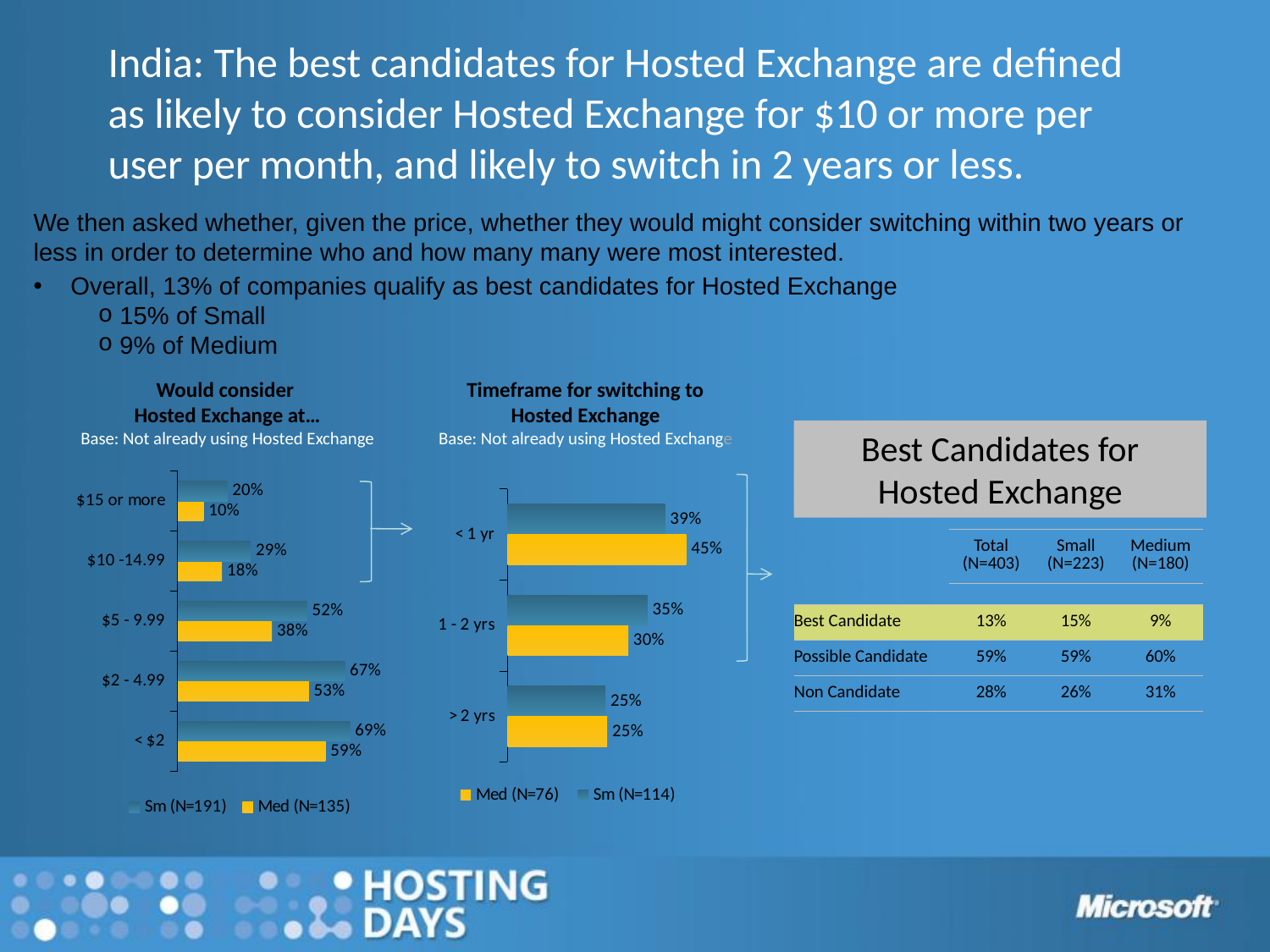
In the 'Timeframe for switching to Hosted Exchange' chart, what is the value for Sm at 1 - 2 yrs? 35% In the 'Would consider Hosted Exchange at...' chart, what is the value for Sm at $15 or more? 20% In the 'Timeframe for switching to Hosted Exchange' chart, which is larger at < 1 yr, Sm or Med? Med In the 'Would consider Hosted Exchange at...' chart, what is the value for Med at $5 - 9.99? 38% How many series does the legend of the 'Timeframe for switching to Hosted Exchange' chart list? 2 In the 'Timeframe for switching to Hosted Exchange' chart, what is the difference between Sm and Med at 1 - 2 yrs? 5% In the 'Timeframe for switching to Hosted Exchange' chart, what is the value for Med at < 1 yr? 45% In the 'Would consider Hosted Exchange at...' chart, what is the difference between the Sm and Med values at $2 - 4.99? 14% In the 'Would consider Hosted Exchange at...' chart, how many price categories are shown? 5 What type of chart is the 'Would consider Hosted Exchange at...' chart? Bar chart In the 'Would consider Hosted Exchange at...' chart, which price category has the highest Sm value? < $2 In the 'Would consider Hosted Exchange at...' chart, which price category has the lowest Med value? $15 or more